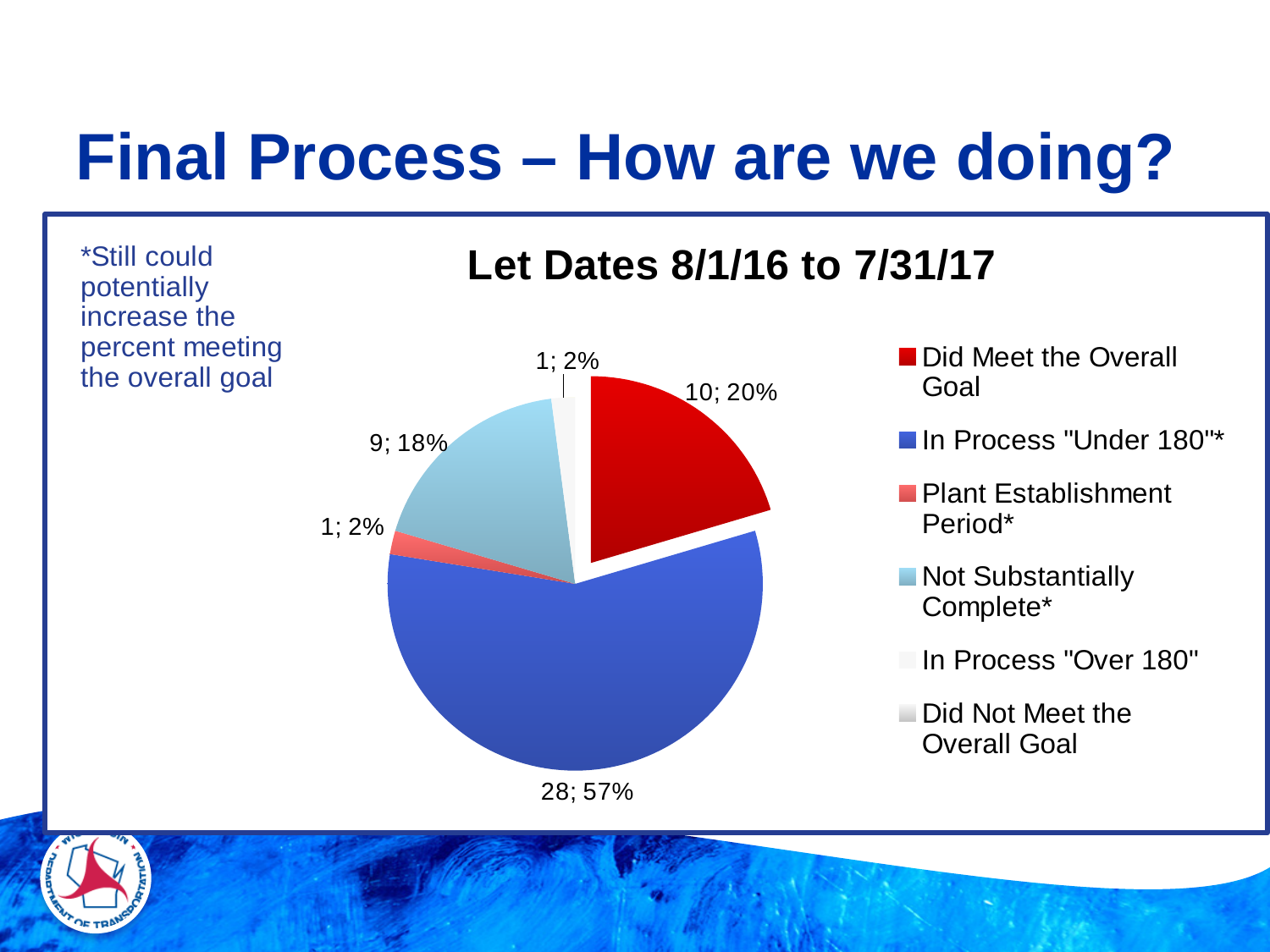
How many entries does the chart's legend list? 6 What share of the pie does "In Process "Under 180"*" represent? 57% What is the title of the chart? Let Dates 8/1/16 to 7/31/17 What kind of chart is shown on the slide? pie chart Which category has the largest slice of the pie? In Process "Under 180"* Which is larger: the "Did Meet the Overall Goal" slice or the "Not Substantially Complete*" slice? Did Meet the Overall Goal How many projects are in the "Not Substantially Complete*" slice? 9 What share of the pie does "Not Substantially Complete*" represent? 18% What share of the pie does "Did Meet the Overall Goal" represent? 20% How many more projects are in "In Process "Under 180"*" than in "Did Meet the Overall Goal"? 18 How many projects are in the "Did Meet the Overall Goal" slice? 10 How many projects are in the "In Process "Under 180"*" slice? 28